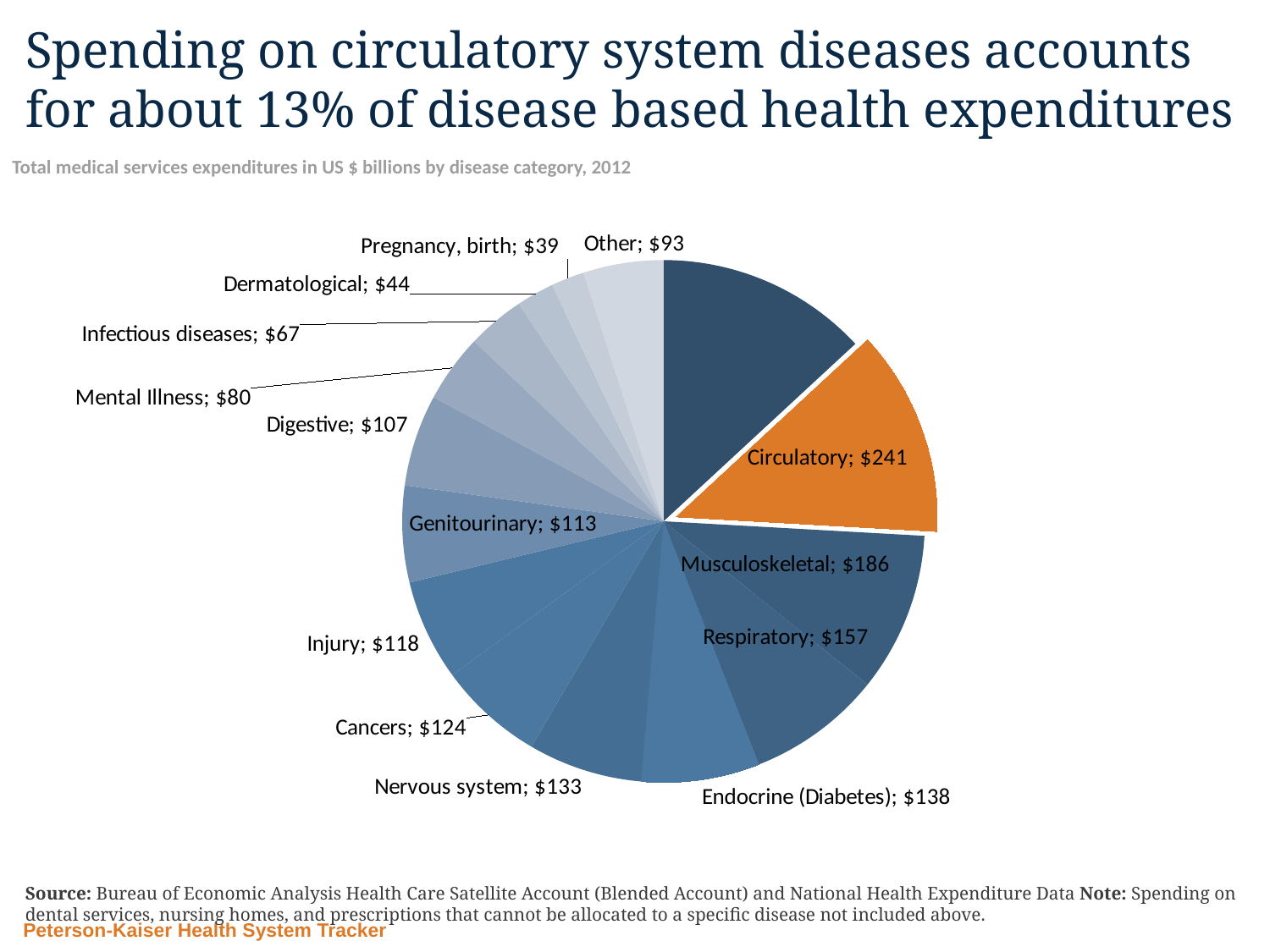
What type of chart is shown on the slide? Pie chart Which slice of the pie chart is highlighted in orange? Circulatory Which disease category has the smallest slice of the pie? Pregnancy, birth What is the spending value for Circulatory? $241 How many disease categories are shown in the pie chart? 15 What is the spending value for Mental Illness? $80 What is the difference between spending on Circulatory and Musculoskeletal? $55 Which is larger, spending on Digestive or spending on Genitourinary? Genitourinary What is the difference between spending on Respiratory and Infectious diseases? $90 What is the spending value for Endocrine (Diabetes)? $138 Which is larger, spending on Cancers or spending on Injury? Cancers